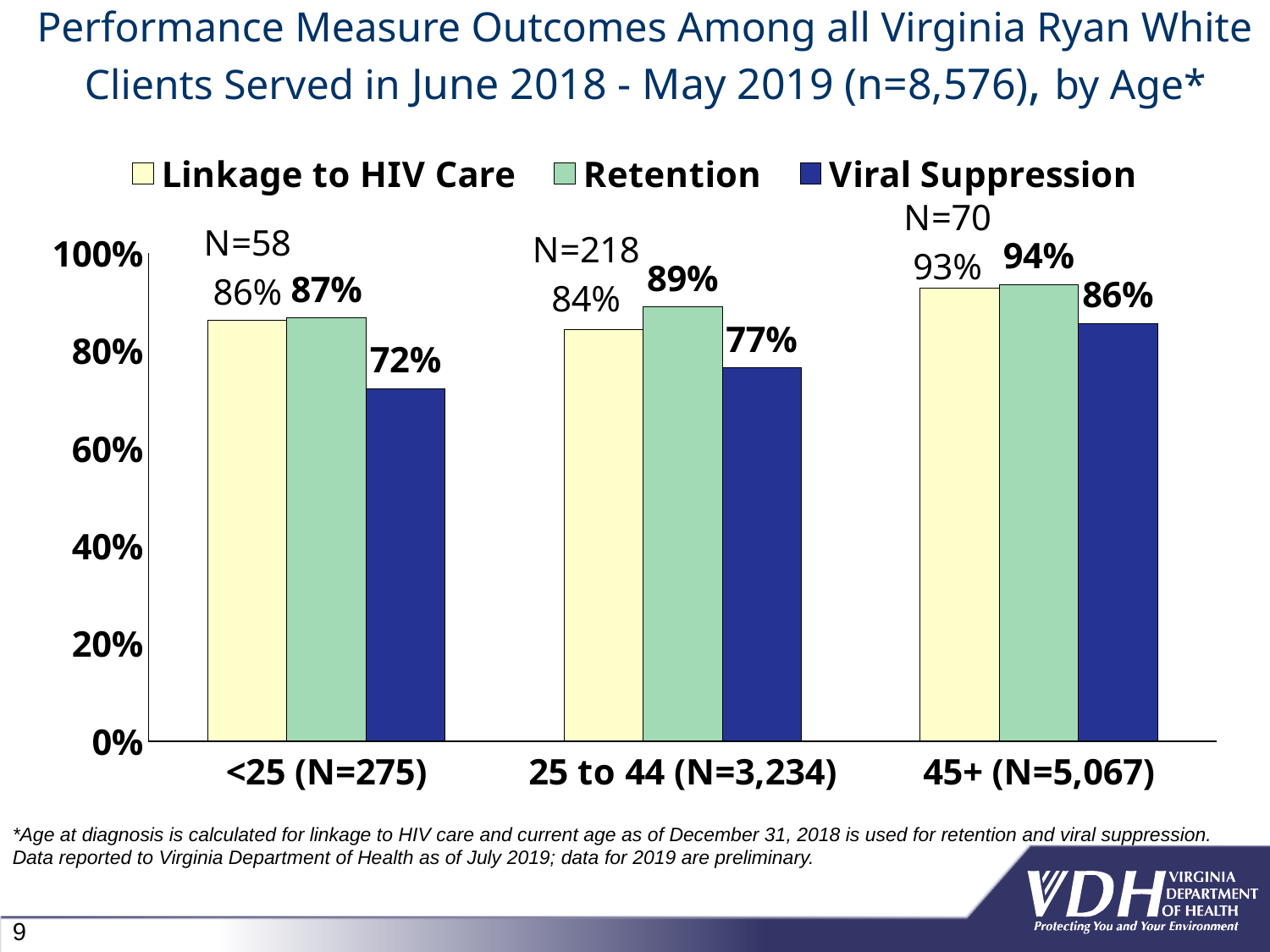
What is the Viral Suppression value for the <25 (N=275) age group? 72% Which is larger for the <25 (N=275) age group: Linkage to HIV Care or Retention? Retention What is the Linkage to HIV Care value for the 45+ (N=5,067) age group? 93% Which age group has the lowest Linkage to HIV Care value? 25 to 44 (N=3,234) How many series does the legend list? 3 What is the Retention value for the 25 to 44 (N=3,234) age group? 89% Do the Viral Suppression values rise or fall across the age groups from <25 to 45+? rise Which age group has the highest Viral Suppression value? 45+ (N=5,067) How many age groups are shown on the x axis? 3 What kind of chart is shown on the slide? bar chart Is the Viral Suppression value for the <25 (N=275) age group greater or less than 80%? less What is the difference between the Retention and Viral Suppression values for the 25 to 44 (N=3,234) age group? 12%